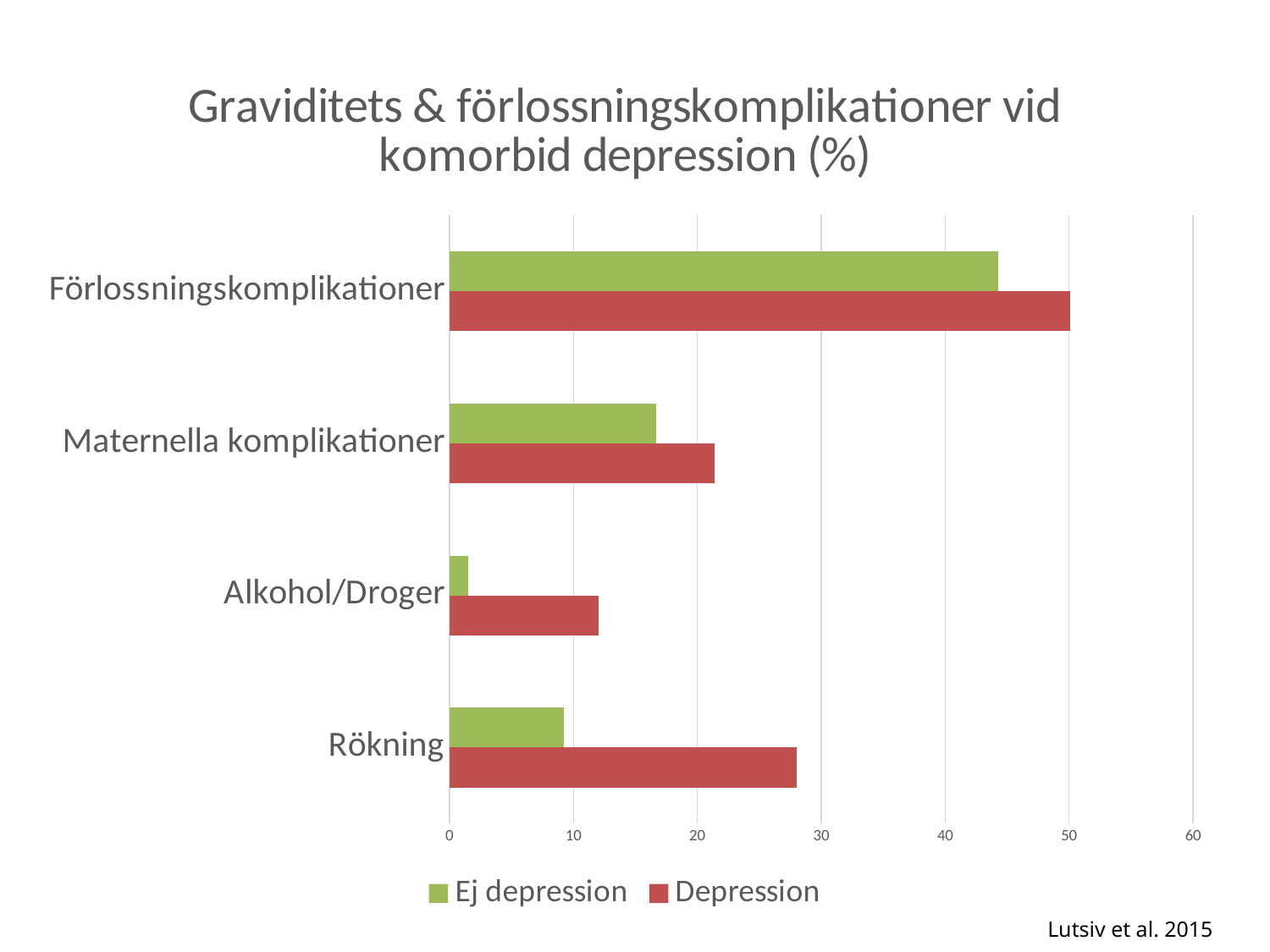
Is the Depression value for Alkohol/Droger greater or less than 10? greater Is the Ej depression value for Förlossningskomplikationer greater or less than 40? greater Is the Depression value for Rökning greater or less than 20? greater Which colour represents the Depression series in the legend? red Which category has the highest value for the Depression series? Förlossningskomplikationer What kind of chart is shown on the slide? bar chart Which is larger: the Depression value for Rökning or the Depression value for Maternella komplikationer? Rökning How many series does the legend list? 2 For Maternella komplikationer, which series has the larger value, Ej depression or Depression? Depression How many categories are shown on the chart? 4 Which category has the lowest value for the Ej depression series? Alkohol/Droger